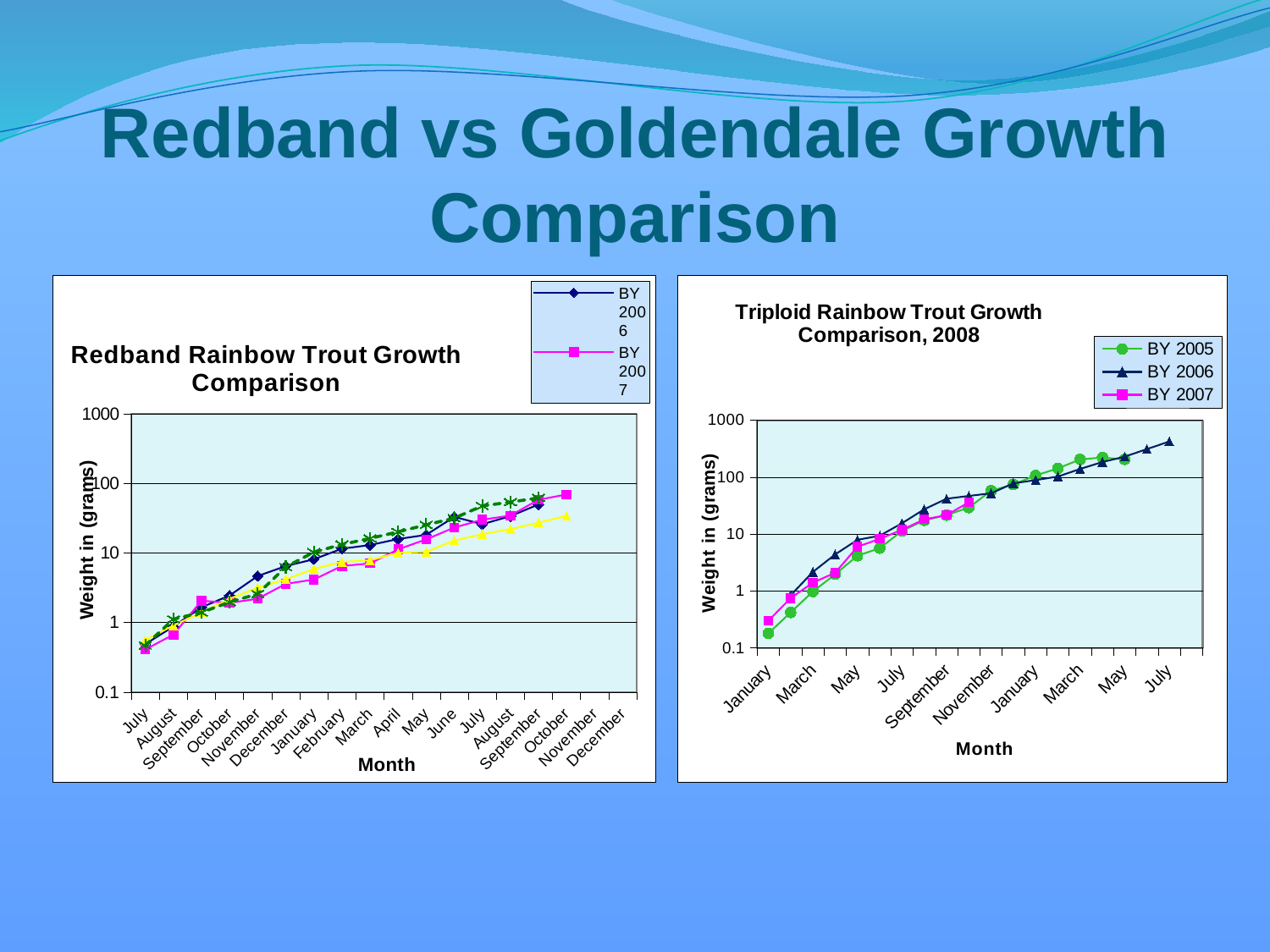
In the Triploid Rainbow Trout Growth Comparison, 2008 chart, is the value for BY 2006 at the final July greater or less than 100? greater In the Redband Rainbow Trout Growth Comparison chart, is the value for BY 2006 in the first July greater or less than 1? less What kind of chart is the Redband Rainbow Trout Growth Comparison chart on the left? line chart What is the y-axis label of the Triploid Rainbow Trout Growth Comparison, 2008 chart? Weight in (grams) How many series does the legend of the Triploid Rainbow Trout Growth Comparison, 2008 chart list? 3 In the Redband Rainbow Trout Growth Comparison chart, do the BY 2007 values rise or fall along the x axis? rise How many month labels are shown on the x axis of the Redband Rainbow Trout Growth Comparison chart? 18 In the Redband Rainbow Trout Growth Comparison chart, is the value for BY 2007 in the final October greater or less than 10? greater How many series does the legend of the Redband Rainbow Trout Growth Comparison chart list? 2 What kind of chart is the Triploid Rainbow Trout Growth Comparison, 2008 chart on the right? line chart In the Triploid Rainbow Trout Growth Comparison, 2008 chart, do the BY 2006 values rise or fall from January to July? rise